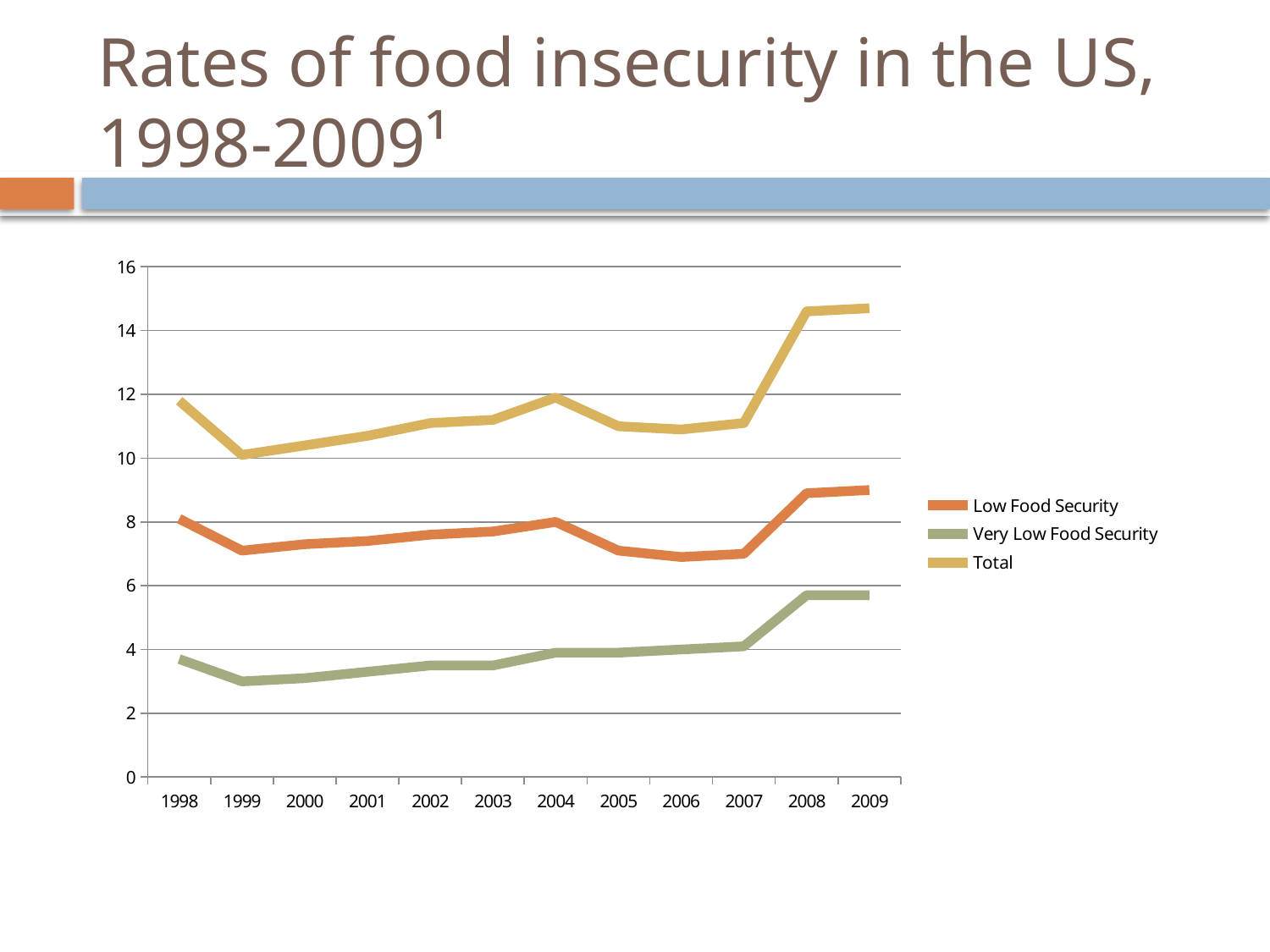
What kind of chart is shown on the slide? Line chart How many years are shown along the x axis? 12 What is the title of the slide? Rates of food insecurity in the US, 1998-2009 Is the value for Total in 2008 greater or less than 14? greater Is the value for Total in 1999 greater or less than 12? less In which year is the Very Low Food Security series at its lowest? 1999 How many series does the legend list? 3 Does the Total series rise or fall between 2007 and 2008? Rise Which series is drawn in orange? Low Food Security Which is larger, the Total value in 2008 or the Total value in 1998? 2008 In which year is the Total series at its lowest? 1999 Is the value for Low Food Security in 2009 greater or less than 8? greater